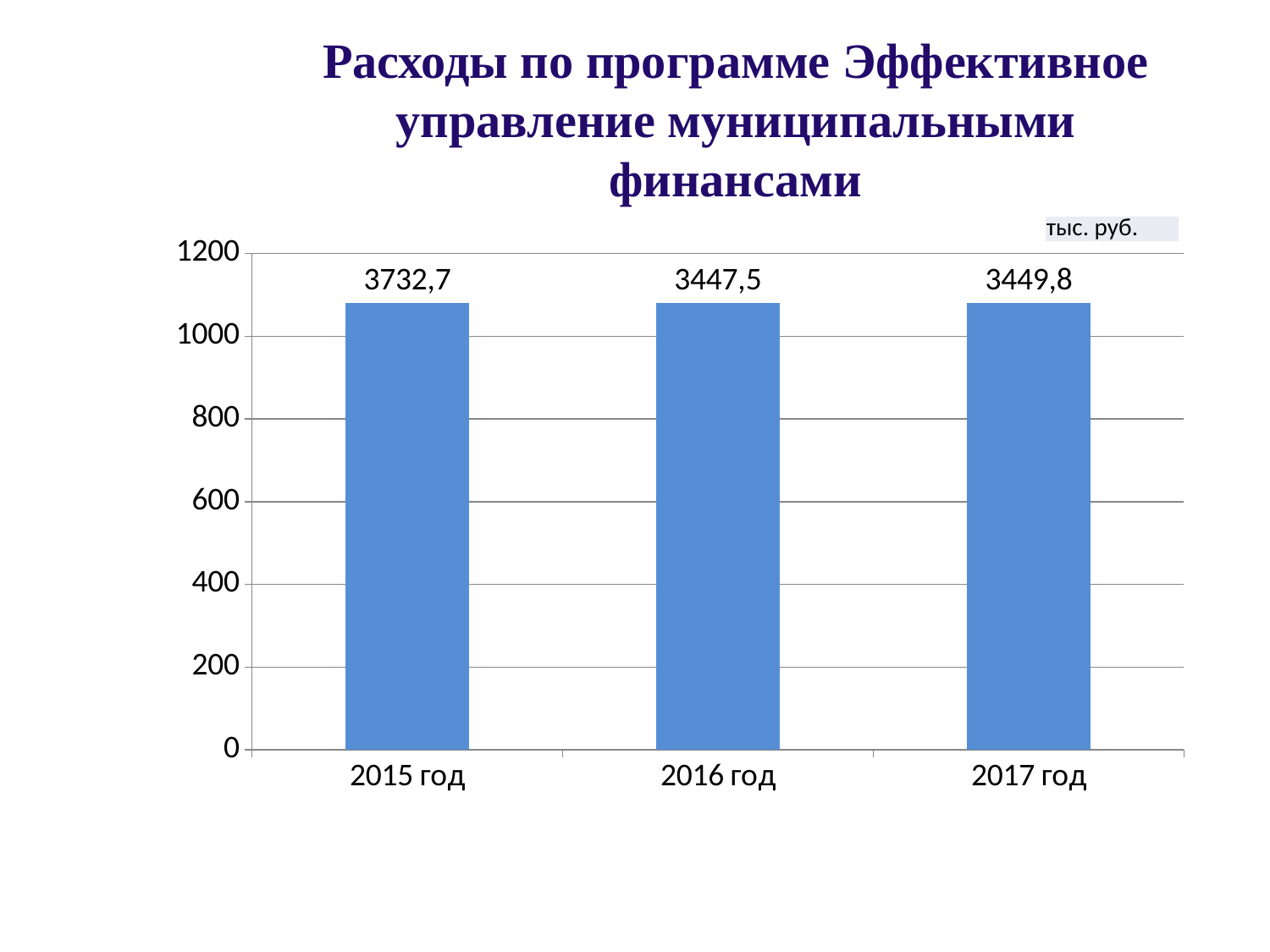
What is the difference between the values for 2017 год and 2016 год? 2,3 Which year has the highest labelled value? 2015 год What is the title of the slide? Расходы по программе Эффективное управление муниципальными финансами What is the value for 2016 год? 3447,5 Which is larger, the value for 2015 год or the value for 2017 год? 2015 год What unit is indicated for the values on the chart? тыс. руб. What is the value for 2015 год? 3732,7 Which year has the lowest labelled value? 2016 год What is the difference between the values for 2015 год and 2016 год? 285,2 How many years are shown on the chart? 3 What is the value for 2017 год? 3449,8 What kind of chart is shown on the slide? Bar chart